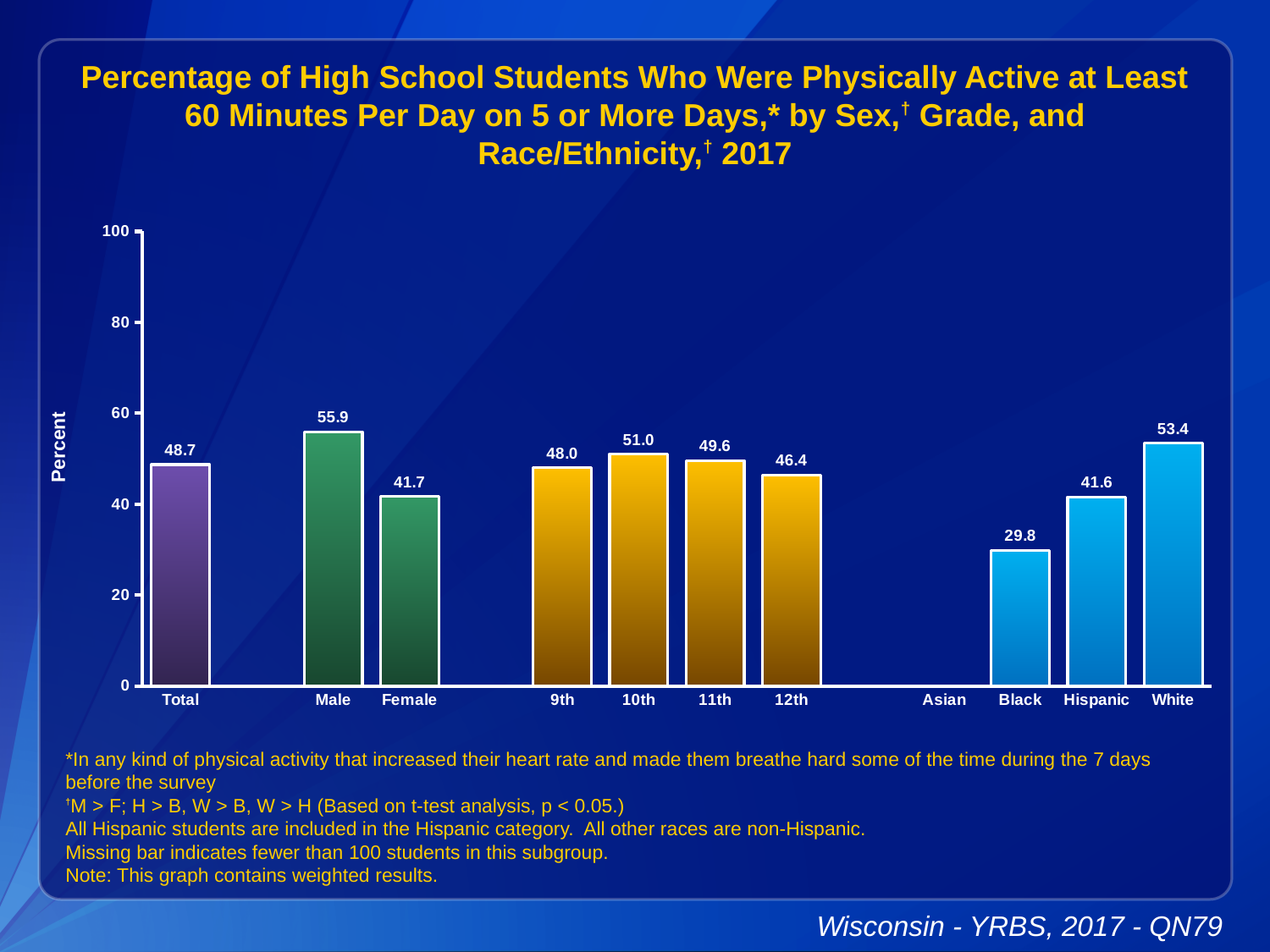
What is the value for Black students? 29.8 Which category has the highest value? Male How many bars are plotted on the chart? 10 Which category label has no bar plotted? Asian What is the difference between the Male and Female values? 14.2 What is the value for Total? 48.7 Which category has the lowest value? Black What kind of chart is shown? Bar chart Which is larger, the value for White or the value for Hispanic? White Is the value for 12th grade greater or less than 40? greater What is the value for Female? 41.7 What is the value for 10th grade? 51.0